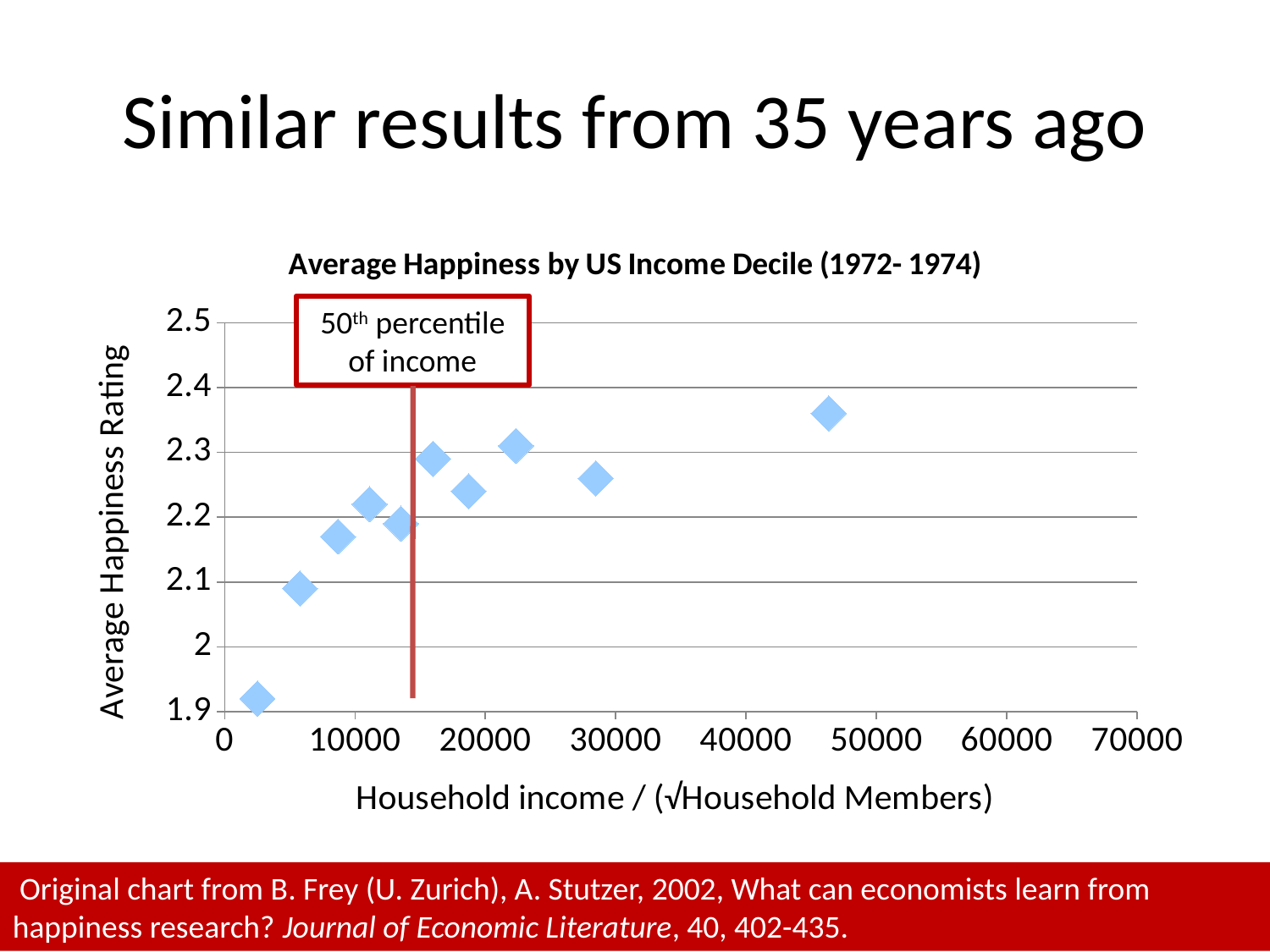
Which has a higher average happiness rating: the point at roughly 11000 household income or the point at roughly 6000 household income? The point at roughly 11000 Which point has the lowest average happiness rating on the chart? The point with the lowest household income (around 2500) Which point has the highest average happiness rating: the one with the lowest household income or the one with the highest household income? The one with the highest household income What is the label of the vertical axis? Average Happiness Rating Is the average happiness rating for the point with the highest household income (around 46000) greater or less than 2.3? greater Is the average happiness rating for the point at roughly 6000 household income greater or less than 2? greater Is the average happiness rating for the point with the lowest household income greater or less than 2? less How many data points are plotted on the chart? 10 What kind of chart is shown on the slide? Scatter plot What is the title of the chart? Average Happiness by US Income Decile (1972- 1974) Overall, does average happiness rating rise or fall as household income increases along the x axis? Rise